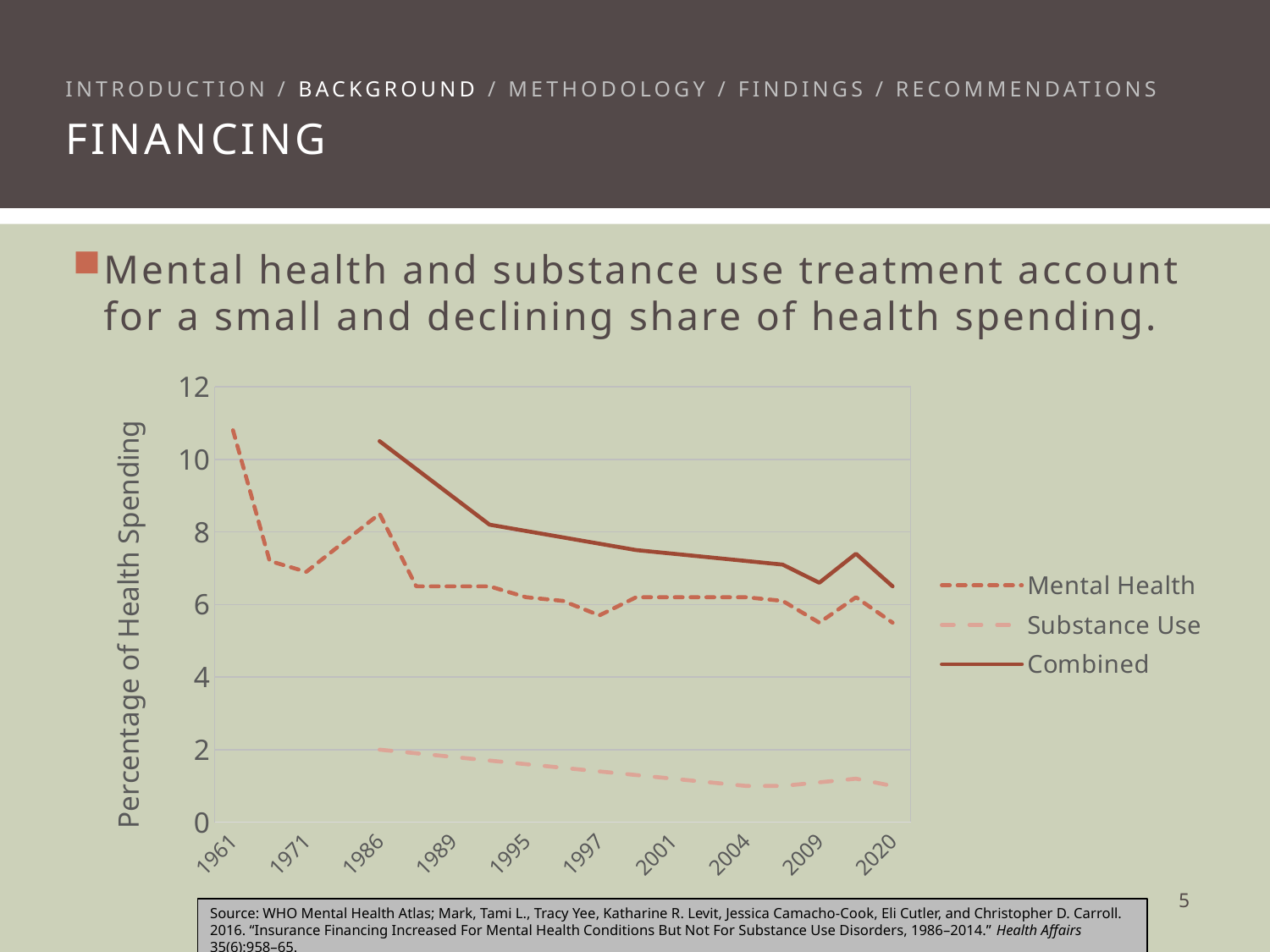
Is the Substance Use value for 2020 greater or less than 2? less Is the Mental Health value for 2020 greater or less than 6? less In which year is the Mental Health series at its highest value? 1961 Is the Mental Health value for 1961 greater or less than 10? greater Does the Combined series generally rise or fall from 1986 to 2020? fall How many series does the chart's legend list? 3 How many year labels are shown along the x axis of the chart? 10 What kind of chart is shown on the slide? line chart Which is larger in 1995, the Mental Health value or the Substance Use value? Mental Health Which series has the highest value in 2004? Combined What is the title of the chart's y axis? Percentage of Health Spending